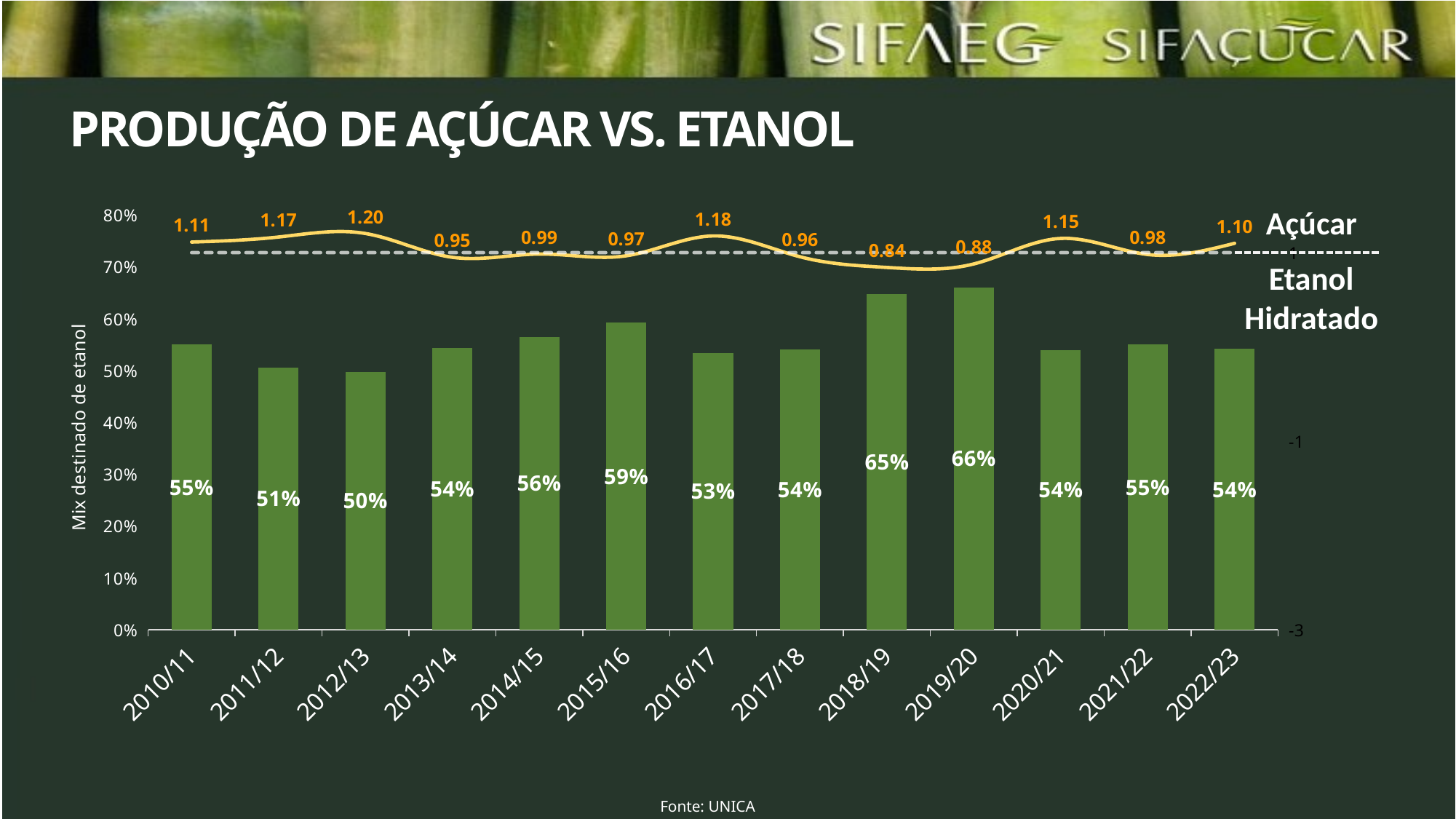
What is the title of the slide's chart? PRODUÇÃO DE AÇÚCAR VS. ETANOL What is the value on the orange line for 2012/13? 1.20 What is the ethanol mix value for 2012/13? 50% Which season has the highest ethanol mix bar? 2019/20 How many seasons are shown on the x axis? 13 What kind of chart is used for the ethanol mix values? Bar chart What is the source cited at the bottom of the slide? UNICA Which season has the lowest ethanol mix bar? 2012/13 What is the ethanol mix value for 2019/20? 66% What is the value on the orange line for 2018/19? 0.84 Which is larger, the ethanol mix for 2015/16 or for 2016/17? 2015/16 What is the difference in ethanol mix between 2019/20 and 2012/13? 16 percentage points